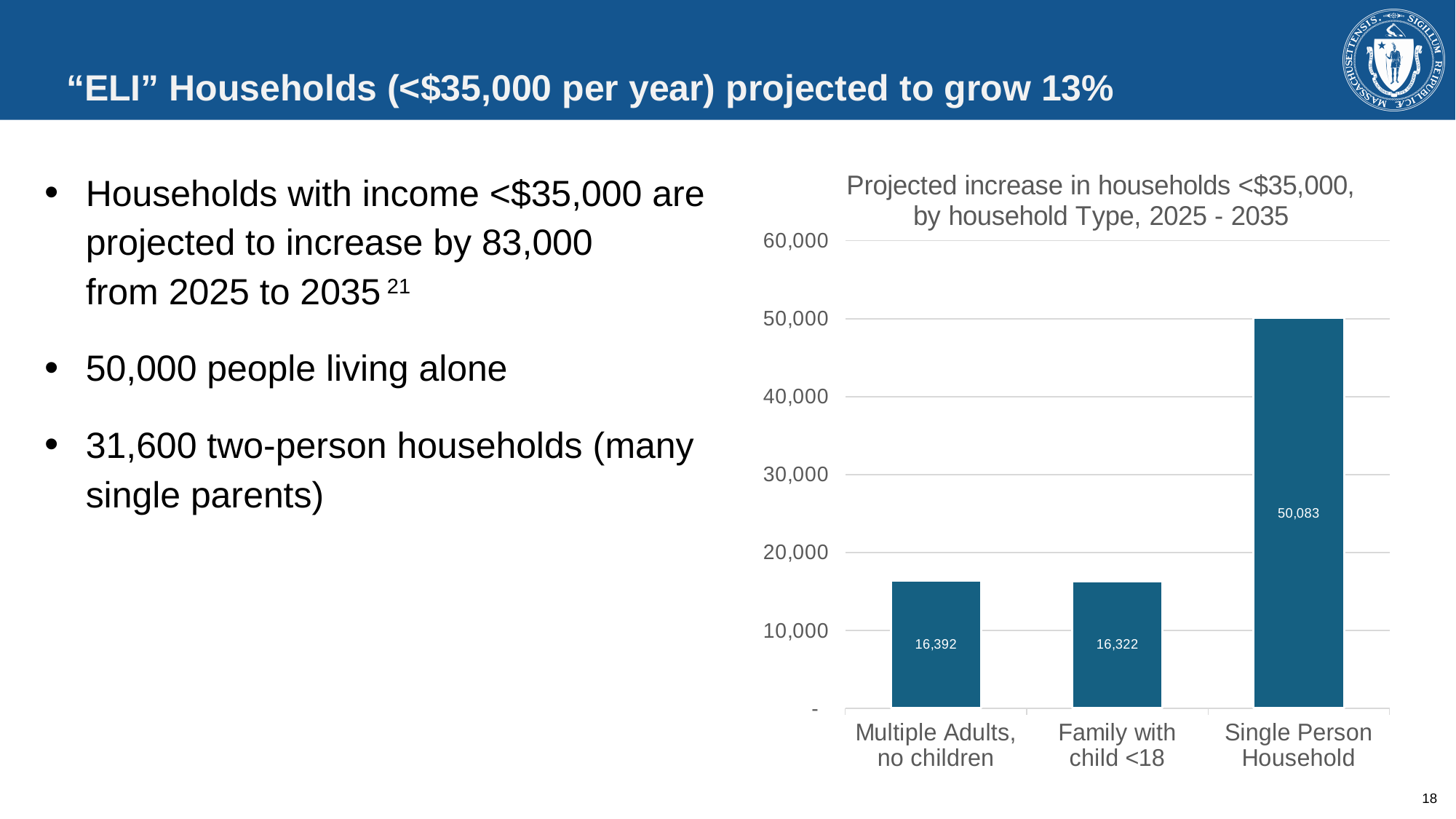
What is the difference between the projected increase for Single Person Household and Family with child <18? 33,761 What is the title of the chart? Projected increase in households <$35,000, by household Type, 2025 - 2035 What kind of chart is shown on the slide? Bar chart What is the projected increase for Multiple Adults, no children? 16,392 How many household types are shown in the chart? 3 Which is larger, the projected increase for Single Person Household or for Family with child <18? Single Person Household Is the value for Single Person Household greater or less than 40,000? greater Is the value for Multiple Adults, no children greater or less than 20,000? less What is the projected increase for Family with child <18? 16,322 What is the projected increase for Single Person Household? 50,083 Which household type has the highest projected increase? Single Person Household What is the difference between the projected increase for Single Person Household and Multiple Adults, no children? 33,691